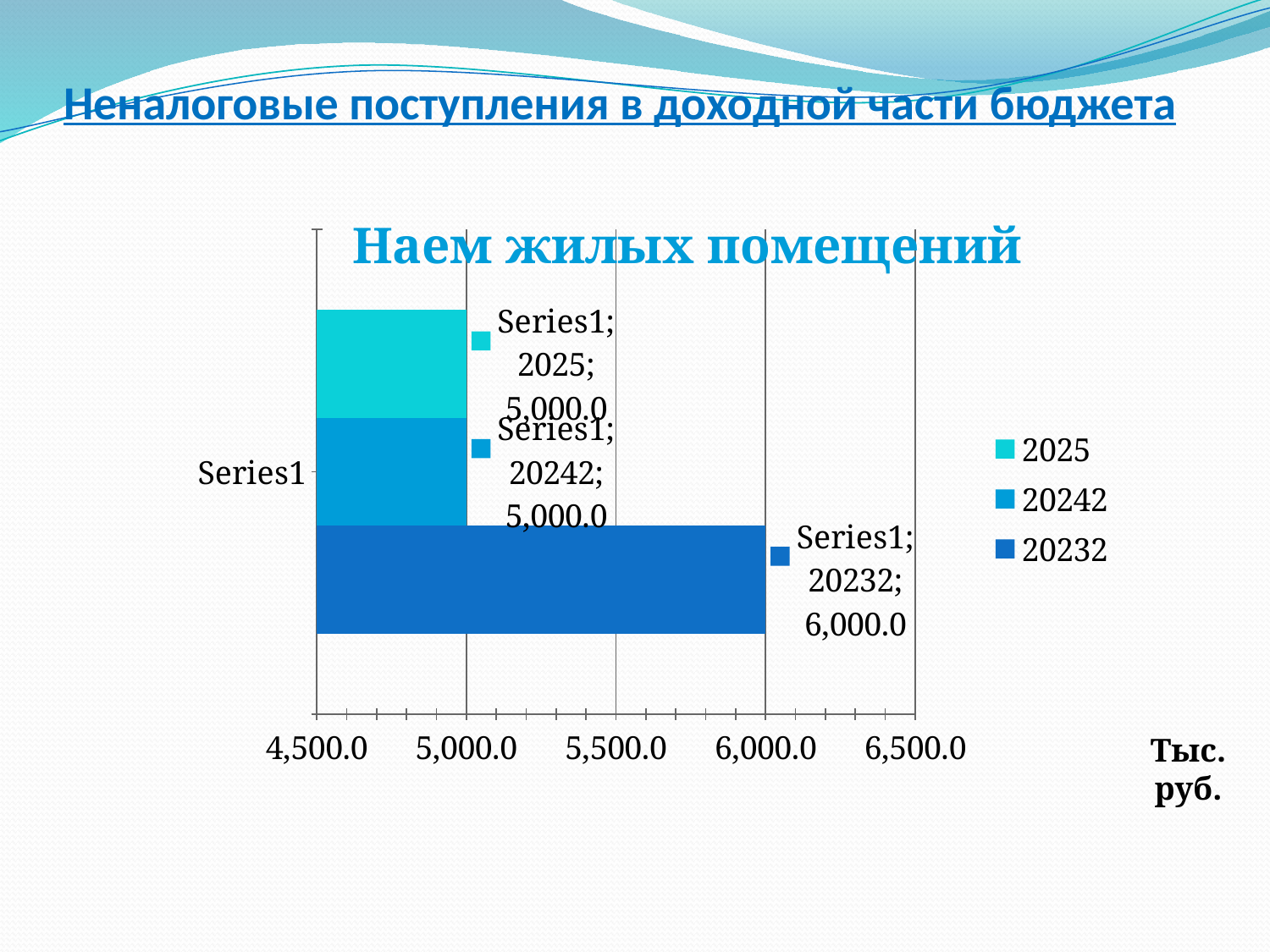
What is the title of the chart? Наем жилых помещений Which series has the highest value in the chart? 20232 Is the value for 20232 greater or less than 5,500.0? greater What unit is indicated next to the chart's axis? Тыс. руб. What is the highest value shown on the horizontal axis of the chart? 6,500.0 What is the value for the 20232 series in the chart? 6,000.0 What is the value for the 20242 series in the chart? 5,000.0 What is the difference between the 20232 value and the 2025 value? 1,000.0 What is the value for the 2025 series in the chart? 5,000.0 How many series does the legend list? 3 What kind of chart is shown on the slide? bar chart Which is larger, the value for 20232 or the value for 20242? 20232